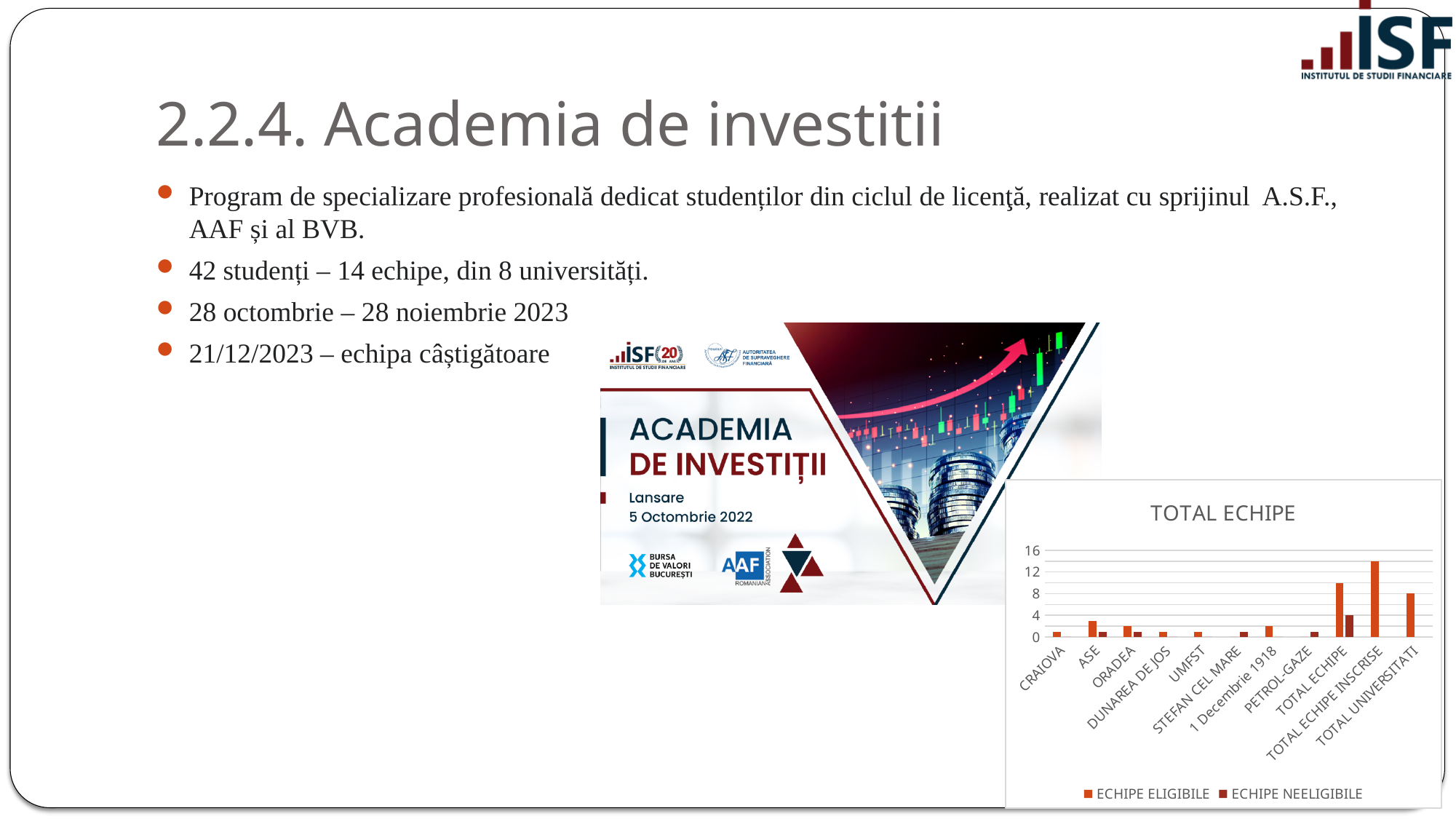
How many series does the chart's legend list? 2 Among the individual universities (CRAIOVA through PETROL-GAZE), which has the highest ECHIPE ELIGIBILE bar? ASE What are the two series named in the chart's legend? ECHIPE ELIGIBILE and ECHIPE NEELIGIBILE Which is larger in the chart: the ECHIPE ELIGIBILE value for TOTAL ECHIPE or for TOTAL UNIVERSITATI? TOTAL ECHIPE Is the ECHIPE ELIGIBILE value for ASE greater or less than 4? less What kind of chart is shown on the slide? bar chart What is the title of the chart on the slide? TOTAL ECHIPE What is the ECHIPE ELIGIBILE value for TOTAL UNIVERSITATI in the chart? 8 How many categories are shown on the x axis of the chart? 11 Which category has the highest ECHIPE ELIGIBILE bar in the chart? TOTAL ECHIPE INSCRISE Is the ECHIPE ELIGIBILE value for TOTAL ECHIPE INSCRISE greater or less than 12? greater Is the ECHIPE ELIGIBILE value for TOTAL ECHIPE greater or less than 8? greater